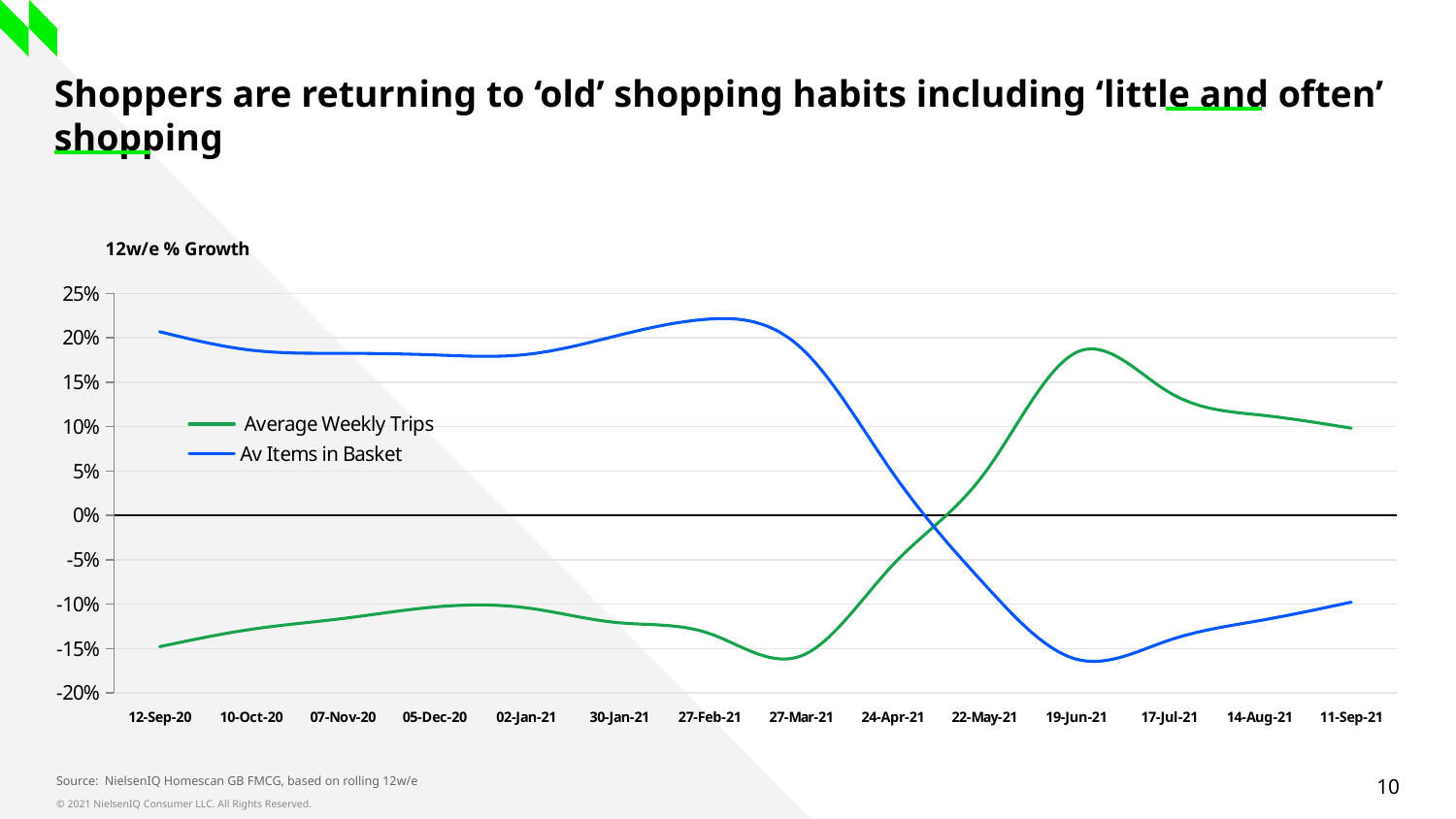
How many series does the chart's legend list? 2 What type of chart is shown on the slide? line chart Does the Av Items in Basket line rise or fall between 27-Feb-21 and 19-Jun-21? fall Is the value for Av Items in Basket at 19-Jun-21 greater or less than -10%? less Does the Average Weekly Trips line rise or fall between 27-Mar-21 and 19-Jun-21? rise What colour is the Average Weekly Trips line in the chart? green At 11-Sep-21, which series has the higher value: Average Weekly Trips or Av Items in Basket? Average Weekly Trips At which date does the Average Weekly Trips line reach its highest point? 19-Jun-21 At 12-Sep-20, which series has the higher value: Average Weekly Trips or Av Items in Basket? Av Items in Basket Is the value for Av Items in Basket at 12-Sep-20 greater or less than 15%? greater How many date labels are shown along the x axis of the chart? 14 Is the value for Average Weekly Trips at 12-Sep-20 greater or less than -10%? less